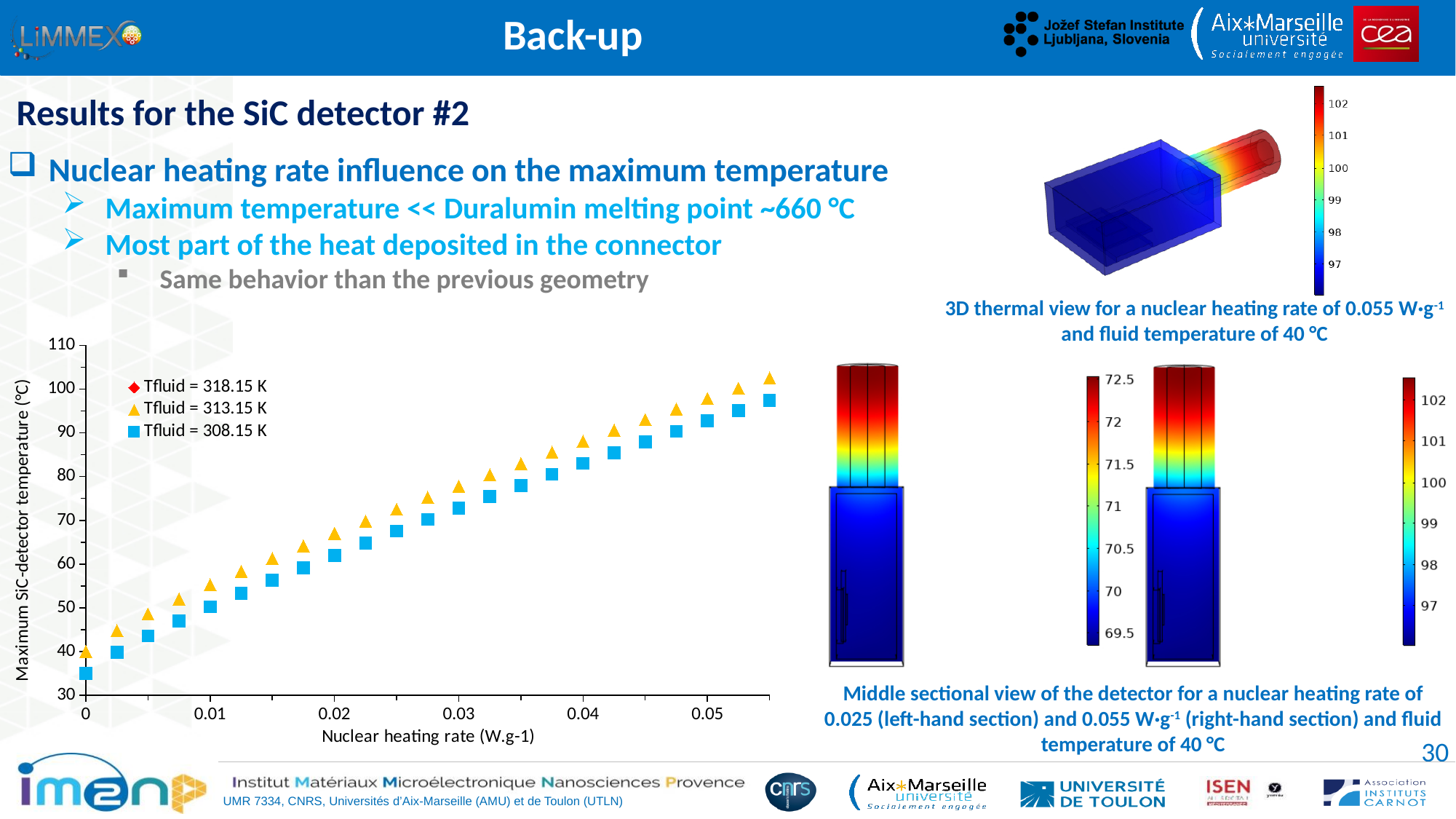
How many series does the legend of the chart list? 3 What kind of chart is shown on the left of the slide? scatter chart What is the title of the y axis of the chart? Maximum SiC-detector temperature (°C) Is the value for Tfluid = 313.15 K at a nuclear heating rate of 0.01 greater or less than 50? greater Is the value for Tfluid = 308.15 K at a nuclear heating rate of 0.04 greater or less than 80? greater Is the value for Tfluid = 313.15 K at a nuclear heating rate of 0.02 greater or less than 70? less At a nuclear heating rate of 0.05, which series has the lower value: Tfluid = 313.15 K or Tfluid = 308.15 K? Tfluid = 308.15 K At a nuclear heating rate of 0.03, which series has the higher value: Tfluid = 313.15 K or Tfluid = 308.15 K? Tfluid = 313.15 K Does the maximum SiC-detector temperature rise or fall as the nuclear heating rate increases? rise What is the title of the x axis of the chart? Nuclear heating rate (W.g-1)